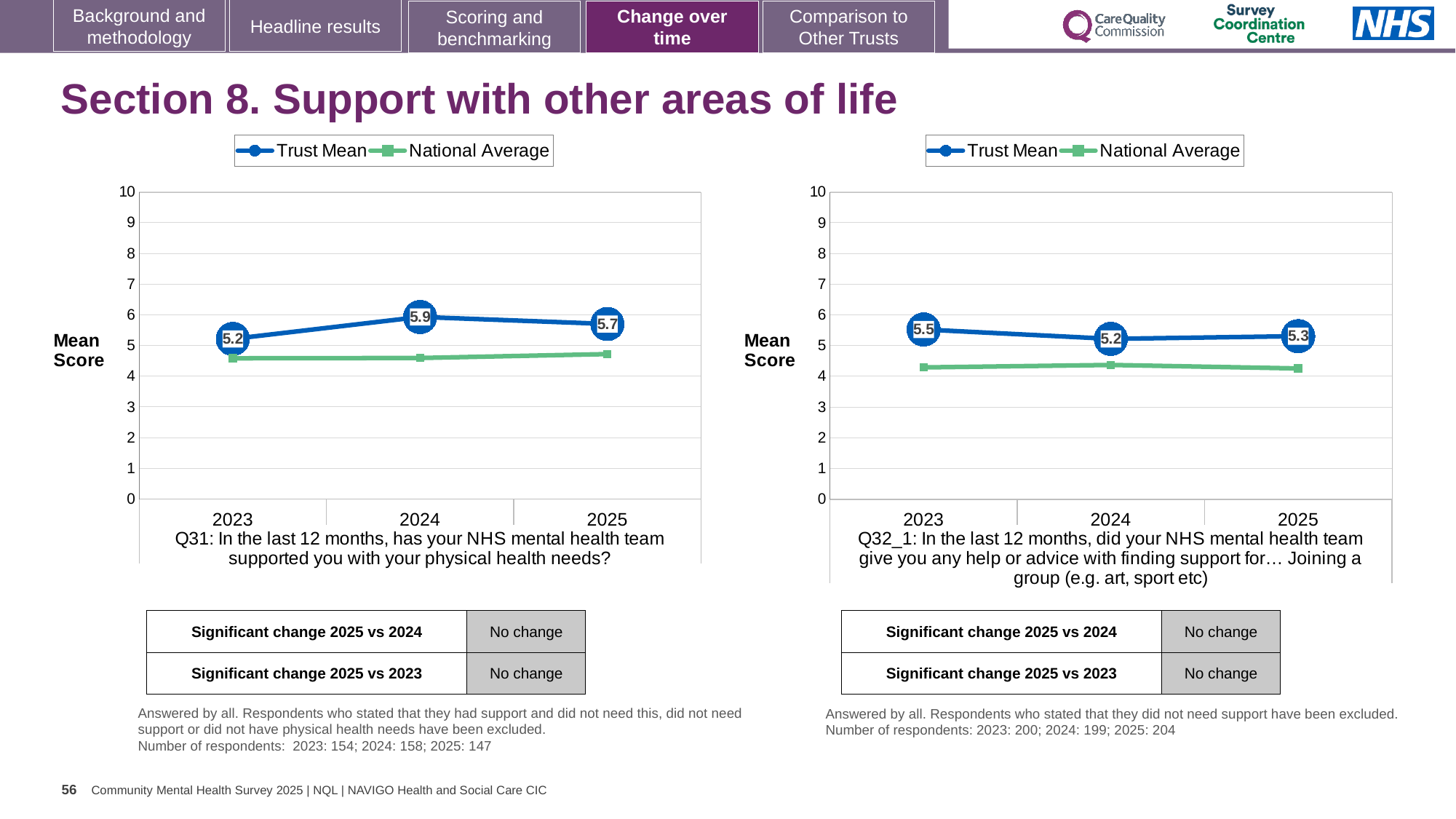
In the Q32_1 chart (right), what is the difference between the Trust Mean scores for 2023 and 2024? 0.3 How many years are shown on the x axis of the Q31 chart (left)? 3 What type of chart is used for Q31 (left)? Line chart In the Q31 chart (left), what is the Trust Mean score for 2024? 5.9 In the Q32_1 chart (right), which year has the highest Trust Mean score? 2023 How many series does the legend of the Q32_1 chart (right) list? 2 In the Q31 chart (left), is the Trust Mean for 2025 higher or lower than the Trust Mean for 2024? lower In the Q32_1 chart (right), is the National Average value for 2023 greater or less than 5? less In the Q31 chart (left), what is the Trust Mean score for 2023? 5.2 In the Q31 chart (left), which year has the lowest Trust Mean score? 2023 In the Q32_1 chart (right), what is the Trust Mean score for 2025? 5.3 In the Q31 chart (left), what is the difference between the Trust Mean scores for 2024 and 2023? 0.7